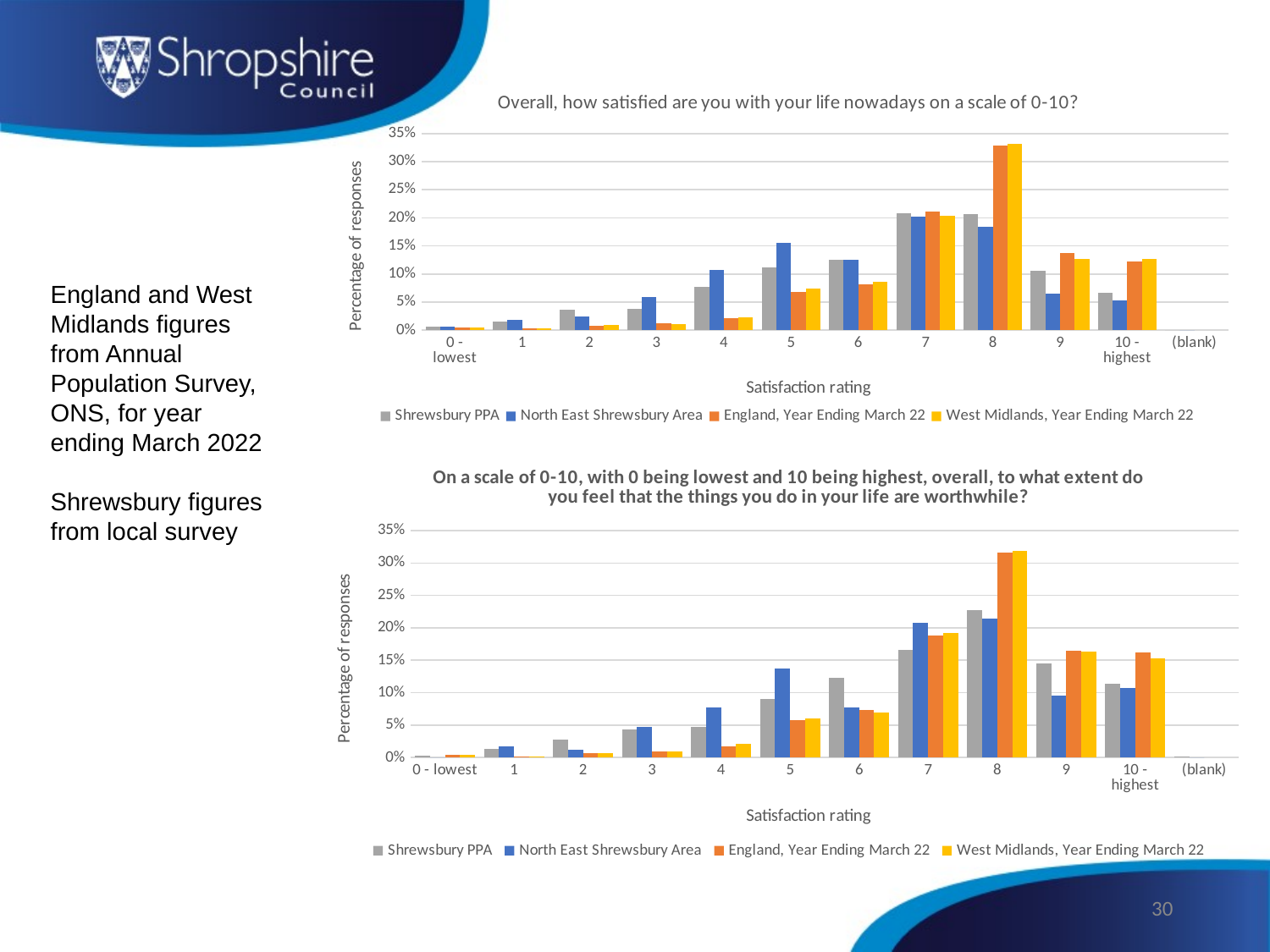
On the bottom chart (things you do are worthwhile), is the value for Shrewsbury PPA at rating 8 greater or less than 20%? greater On the top chart (life satisfaction), how many satisfaction rating categories are shown on the x axis? 12 On the top chart (life satisfaction), at rating 5, which is larger: North East Shrewsbury Area or England, Year Ending March 22? North East Shrewsbury Area On the top chart (life satisfaction), how many series does the legend list? 4 On the bottom chart (things you do are worthwhile), which satisfaction rating has the highest value for West Midlands, Year Ending March 22? 8 What is the label of the y axis on the bottom chart (things you do are worthwhile)? Percentage of responses On the bottom chart (things you do are worthwhile), is the value for North East Shrewsbury Area at rating 5 greater or less than 10%? greater On the bottom chart (things you do are worthwhile), at rating 6, which is larger: Shrewsbury PPA or England, Year Ending March 22? Shrewsbury PPA On the top chart (life satisfaction), is the value for Shrewsbury PPA at rating 9 greater or less than 15%? less What kind of chart is the bottom chart (things you do are worthwhile)? Bar chart On the top chart (life satisfaction), which satisfaction rating has the highest value for England, Year Ending March 22? 8